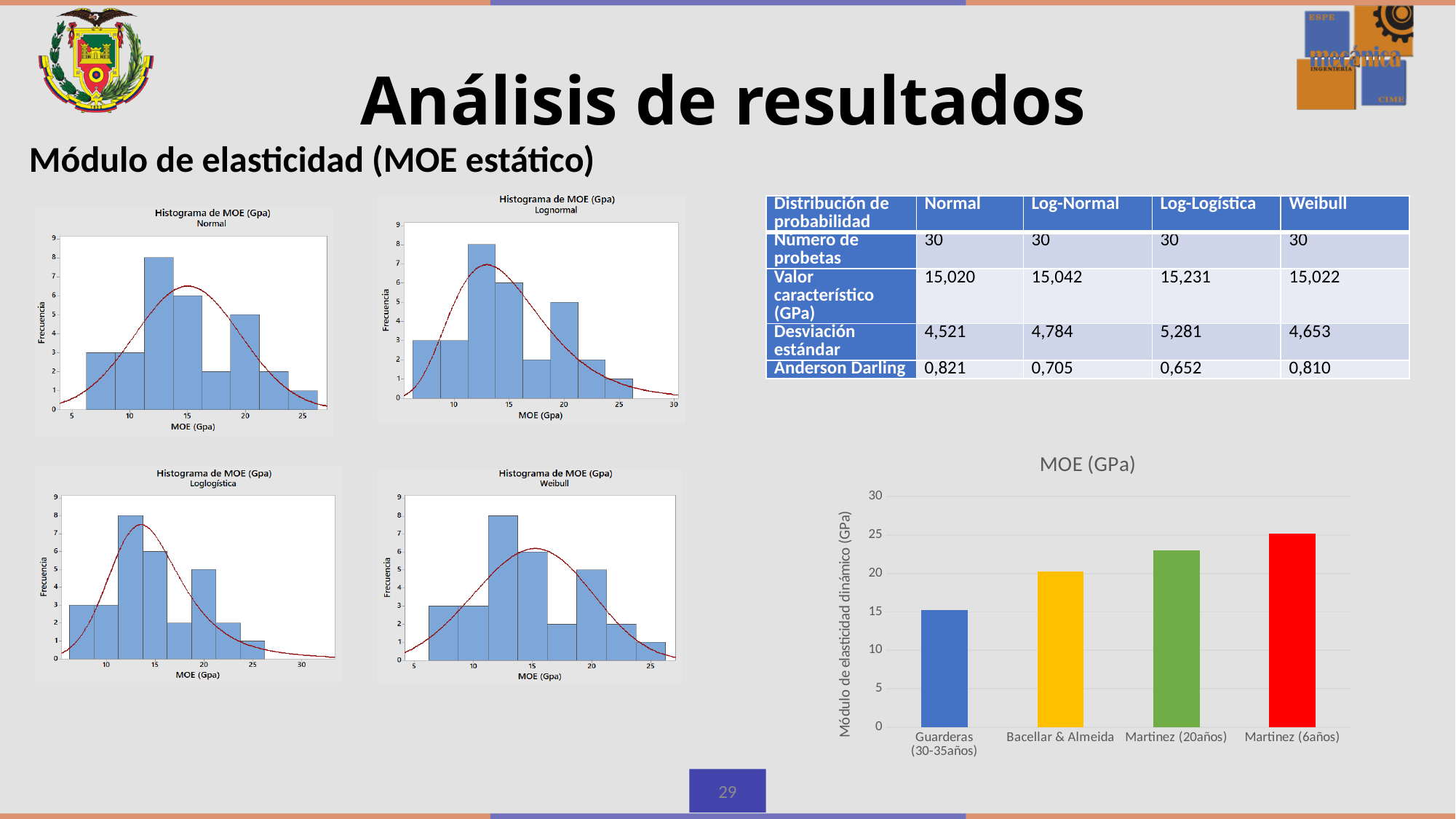
What kind of chart is the 'MOE (GPa)' chart on the right of the slide? bar chart In the 'MOE (GPa)' bar chart, what colour is the bar for Martinez (6años)? red In the 'MOE (GPa)' bar chart, is the value for Martinez (6años) greater or less than 20? greater In the 'Histograma de MOE (Gpa) Normal' chart at the top left, what is the frequency of the tallest bar? 8 In the 'MOE (GPa)' bar chart, is the value for Guarderas (30-35años) greater or less than 20? less How many histograms are shown on the left side of the slide? 4 In the 'MOE (GPa)' bar chart, which category has the highest value? Martinez (6años) In the 'MOE (GPa)' bar chart, which is larger: the value for Bacellar & Almeida or the value for Martinez (20años)? Martinez (20años) How many categories are shown on the x axis of the 'MOE (GPa)' bar chart? 4 In the 'MOE (GPa)' bar chart, which category has the lowest value? Guarderas (30-35años) In the 'MOE (GPa)' bar chart, do the values rise or fall from left to right along the x axis? rise What is the y-axis title of the 'MOE (GPa)' bar chart? Módulo de elasticidad dinámico (GPa)